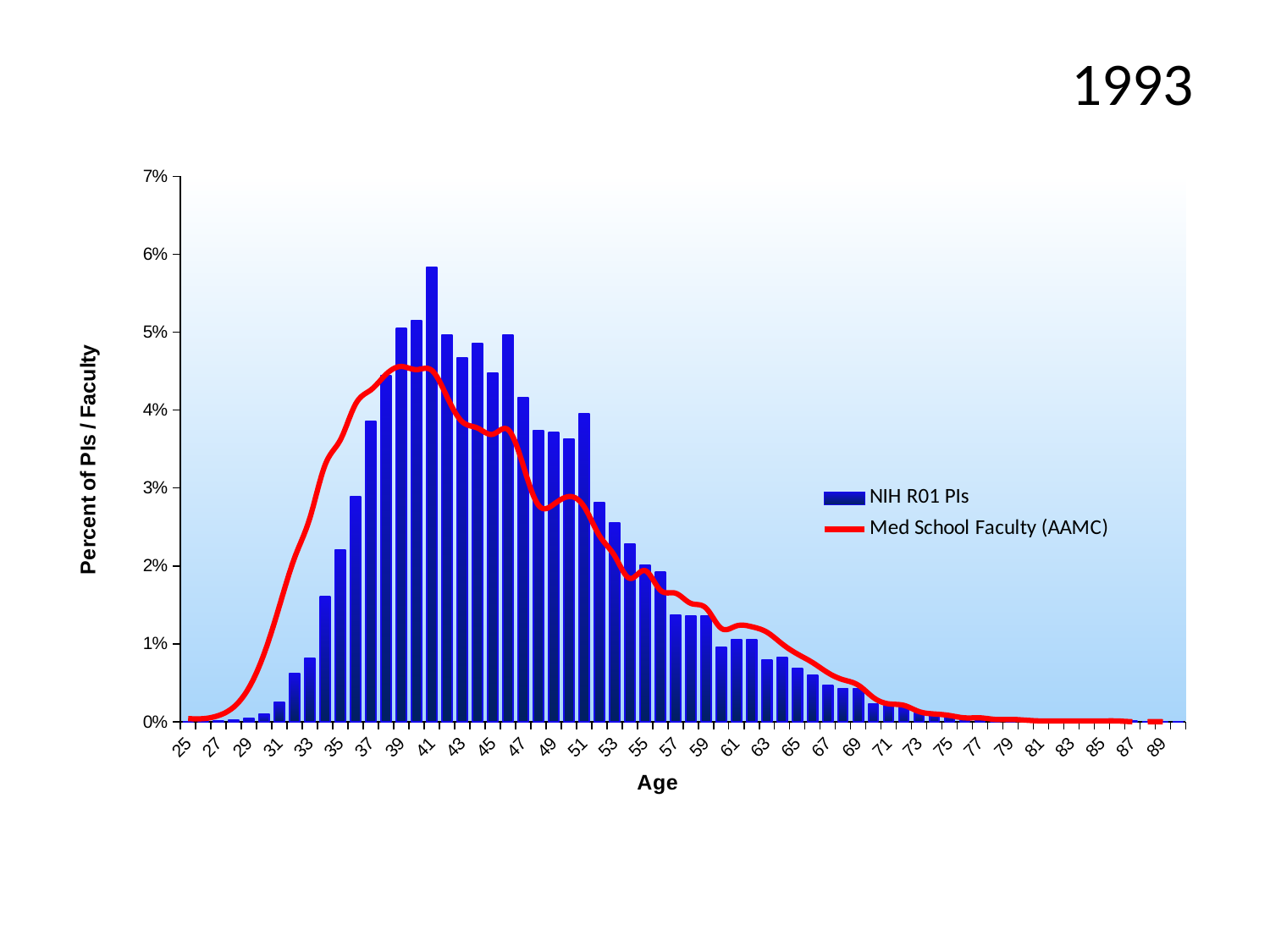
What kind of chart is shown on the slide? A bar chart with a line overlay Is the peak of the Med School Faculty (AAMC) line greater or less than 5%? less Is the NIH R01 PIs value at age 31 greater or less than 1%? less What year is shown as the title of the slide? 1993 Do the NIH R01 PIs values generally rise or fall from age 41 to age 69? fall Is the NIH R01 PIs value at age 41 greater or less than 5%? greater At which age is the NIH R01 PIs bar highest? 41 At age 31, which is larger: the NIH R01 PIs bar or the Med School Faculty (AAMC) line? Med School Faculty (AAMC) line How many series does the legend list? 2 At age 41, which is larger: the NIH R01 PIs bar or the Med School Faculty (AAMC) line? NIH R01 PIs bar